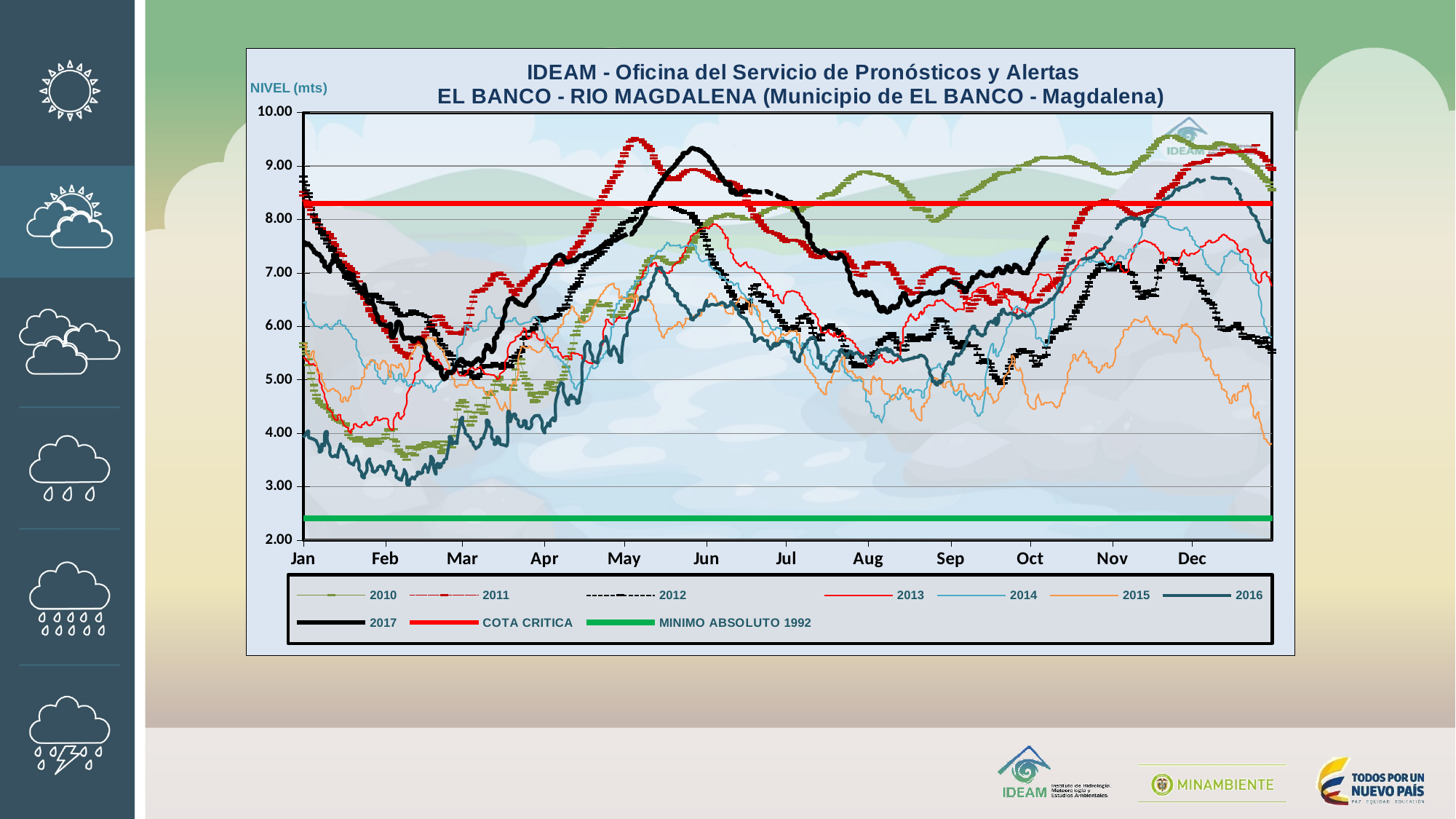
What kind of chart is shown on the slide? line chart Is the value of the 2016 series in Feb greater or less than 4.00? less How many months are labelled along the x axis? 12 Does the 2015 series rise or fall from Oct to Dec? fall How many series does the legend list? 10 Is the value of the COTA CRITICA line greater or less than 8.00? greater What colour is the COTA CRITICA line in the legend? red Which is larger, the COTA CRITICA line or the MINIMO ABSOLUTO 1992 line? COTA CRITICA Is the value of the MINIMO ABSOLUTO 1992 line greater or less than 3.00? less What is the label of the y axis? NIVEL (mts)